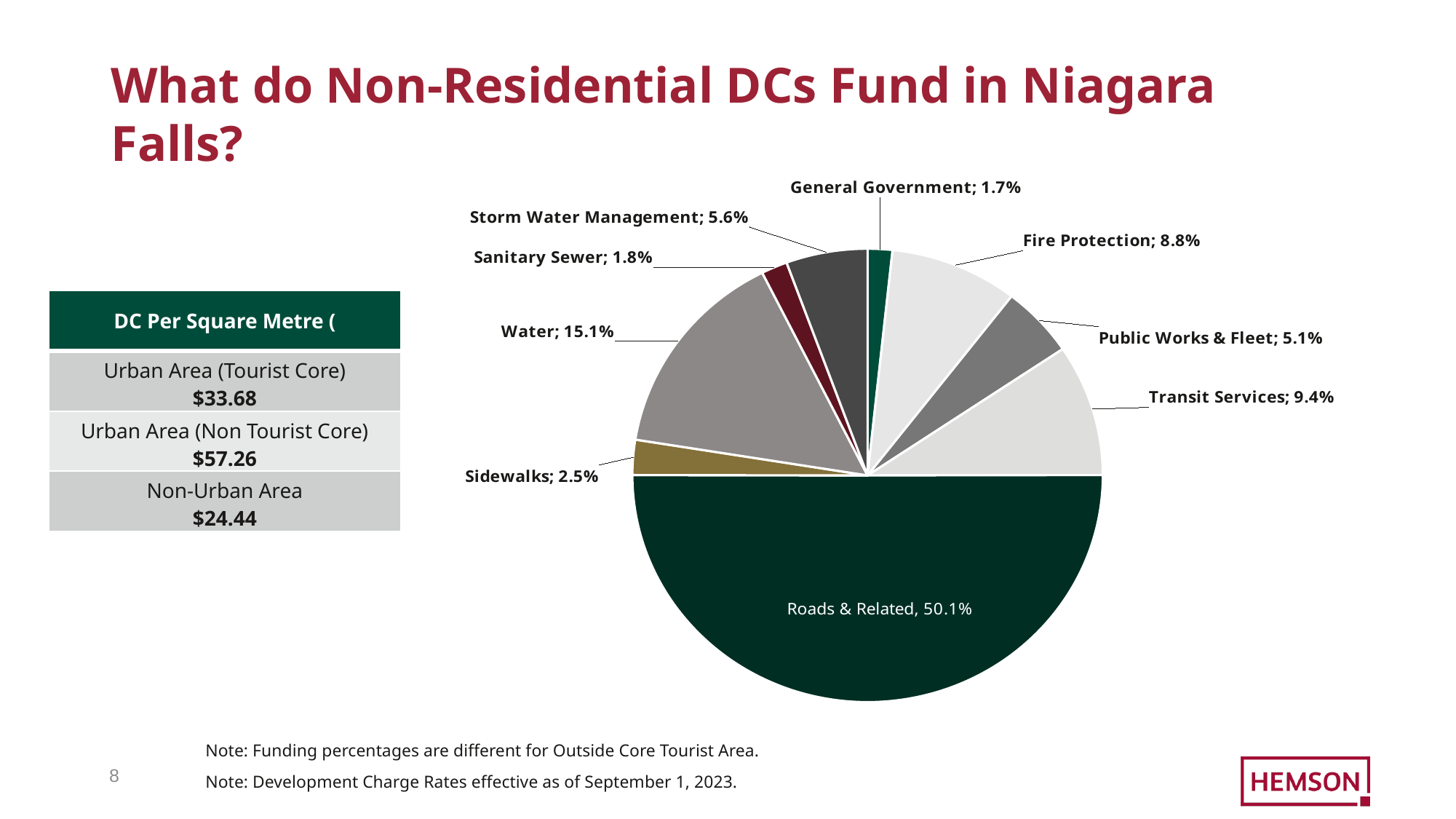
What is the difference between the Fire Protection and Public Works & Fleet percentages? 3.7% What is the value shown for Water? 15.1% What share of the pie does Roads & Related account for? 50.1% How many slices does the pie chart have? 9 What kind of chart is shown on the slide? Pie chart What is the value shown for Storm Water Management? 5.6% What colour is the Roads & Related slice? Dark green Which is larger, Transit Services or Fire Protection? Transit Services Which category has the largest slice of the pie? Roads & Related What is the value shown for Transit Services? 9.4% Which category has the smallest slice of the pie? General Government What is the difference between the Water and Sidewalks percentages? 12.6%